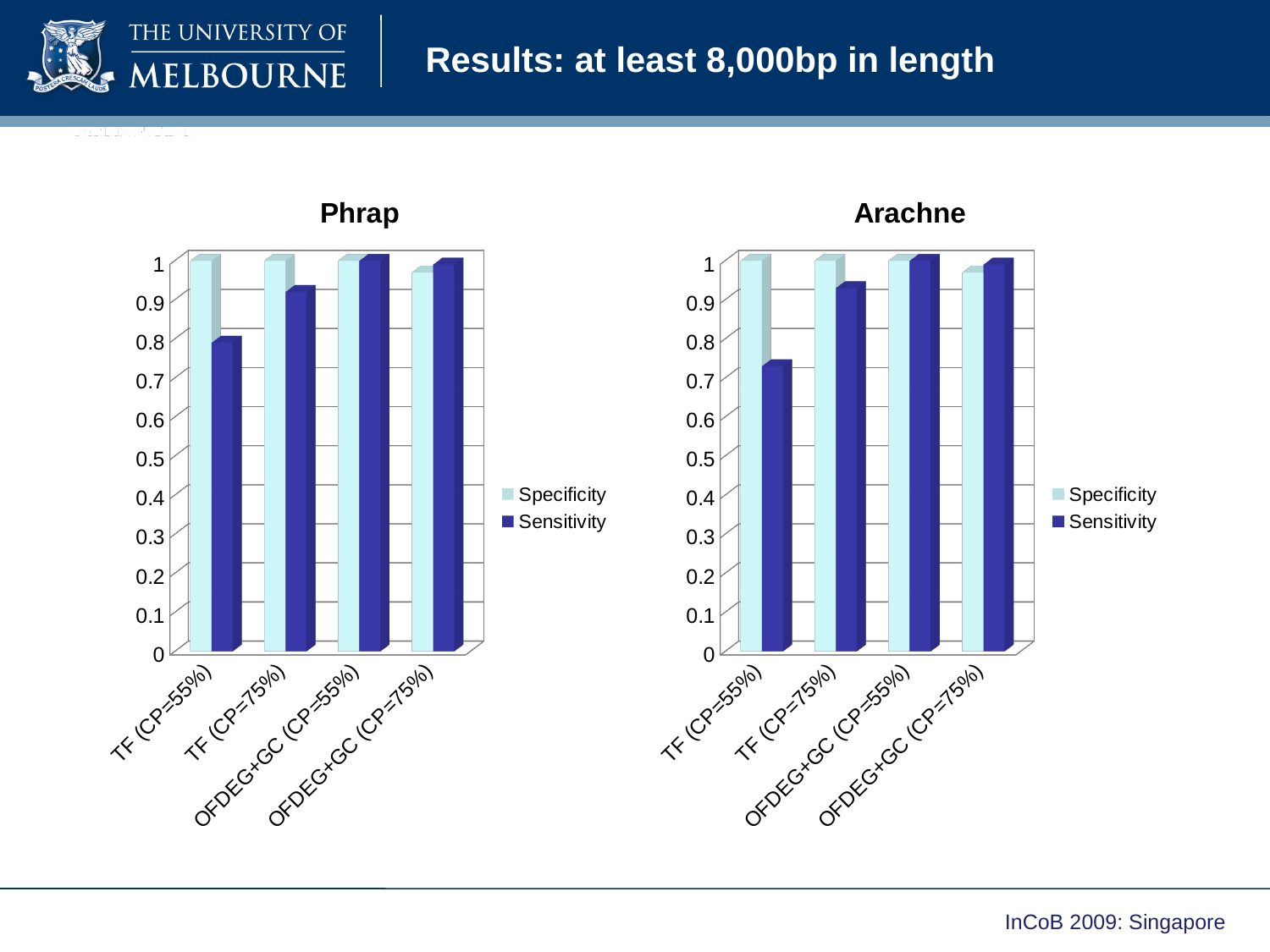
In the Phrap chart, is the Sensitivity for TF (CP=55%) greater or less than 0.9? less In the Phrap chart, which is larger: the Sensitivity for TF (CP=55%) or the Sensitivity for TF (CP=75%)? TF (CP=75%) In the Arachne chart, is the Sensitivity for TF (CP=55%) greater or less than 0.8? less In the Arachne chart, which is larger for TF (CP=55%): Specificity or Sensitivity? Specificity In the Phrap chart, does Sensitivity generally rise or fall from TF (CP=55%) to OFDEG+GC (CP=55%)? rise How many series does the legend of the Phrap chart list? 2 In the Arachne chart, is the Sensitivity for TF (CP=75%) greater or less than 0.8? greater In the Phrap chart, which category has the lowest Sensitivity? TF (CP=55%) What are the two series named in the legend of the Arachne chart? Specificity and Sensitivity In the Arachne chart, which category has the lowest Sensitivity? TF (CP=55%) What kind of chart is the Phrap chart? bar chart How many categories are shown on the x axis of the Arachne chart? 4